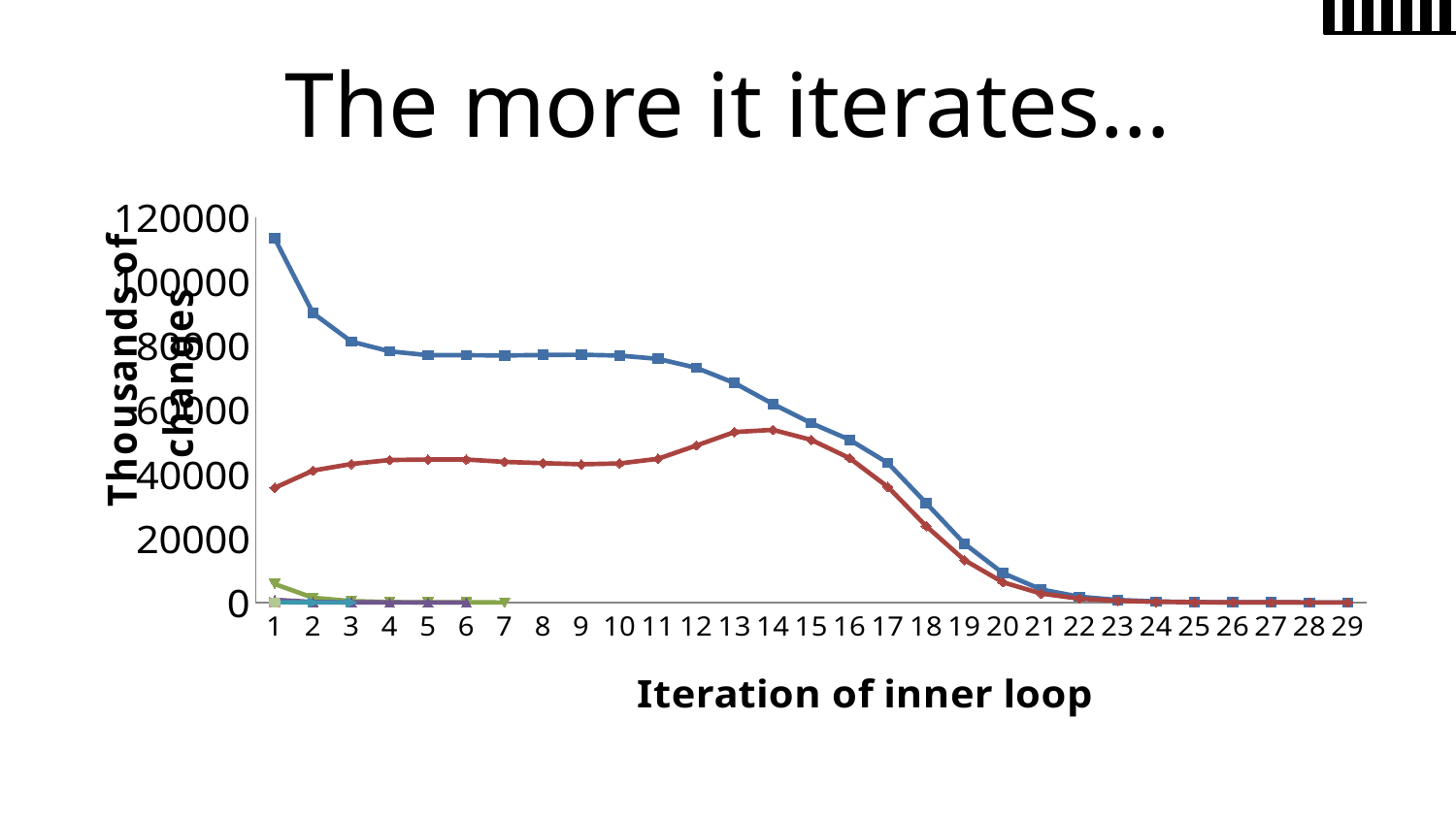
At iteration 1, which line has the higher value, the blue line or the red line? the blue line How many iterations are labelled along the x axis of the chart? 29 What is the title of the x axis of the chart? Iteration of inner loop Is the value of the blue line at iteration 25 greater or less than 20000? less At which iteration does the blue line reach its highest value? 1 What kind of chart is shown on the slide? line chart Is the value of the blue line at iteration 10 greater or less than 60000? greater Is the value of the red line at iteration 1 greater or less than 40000? less Does the blue line generally rise or fall from iteration 1 to iteration 29? fall What is the title of the y axis of the chart? Thousands of changes